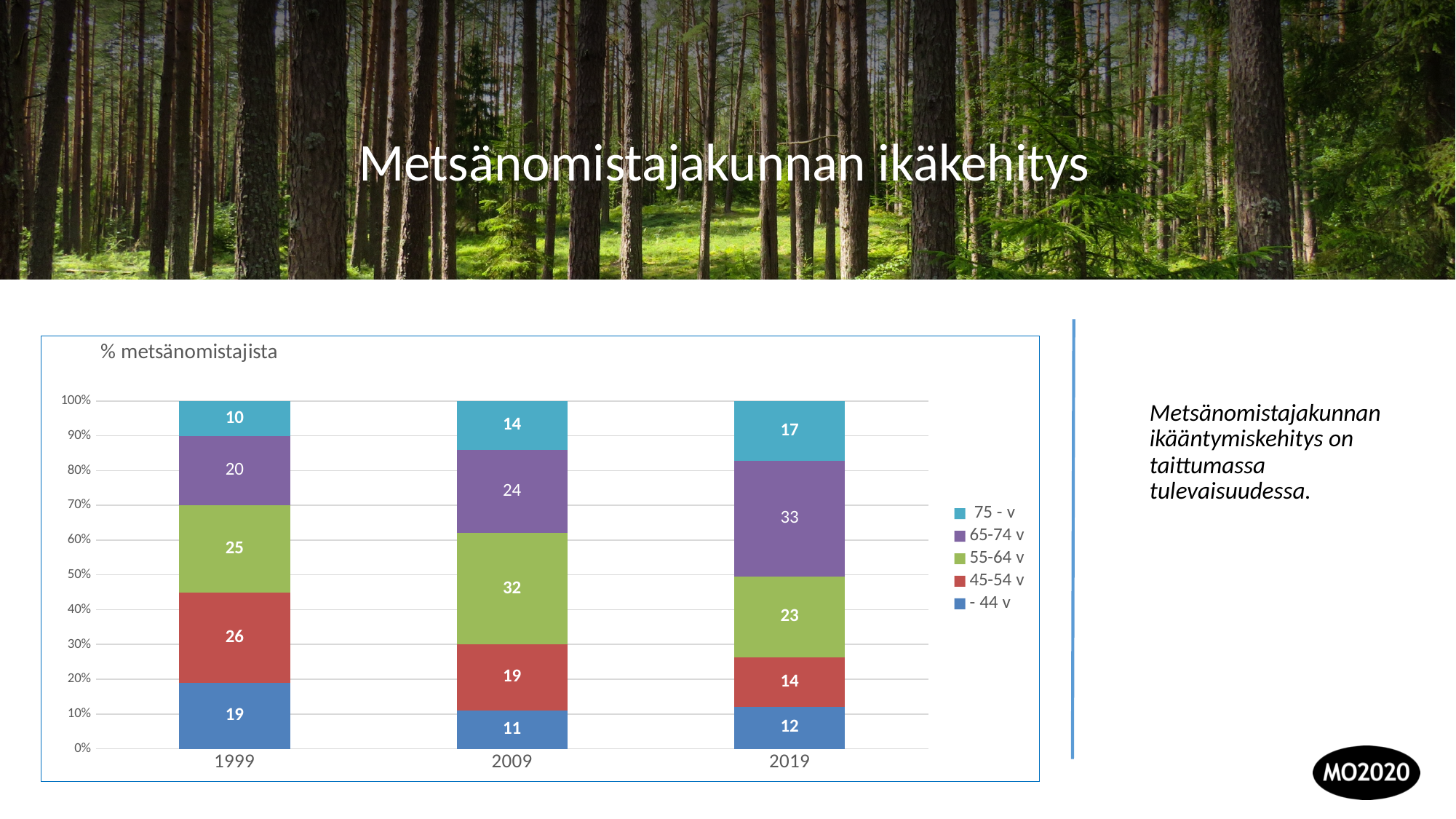
What is the value for the 65-74 v series in 2019? 33 What kind of chart is shown on the slide? stacked bar chart What is the value for the 55-64 v series in 2009? 32 How many series does the legend list? 5 What is the difference between the 65-74 v values in 2019 and 1999? 13 What is the axis title shown above the chart? % metsänomistajista How many years are shown on the x axis? 3 In which year is the value for the 75 - v series highest? 2019 Which is larger: the 45-54 v value in 1999 or the 45-54 v value in 2009? 1999 In which year is the value for the 45-54 v series lowest? 2019 What is the value for the - 44 v series in 1999? 19 How does the value for the 75 - v series change from 1999 to 2019? rises